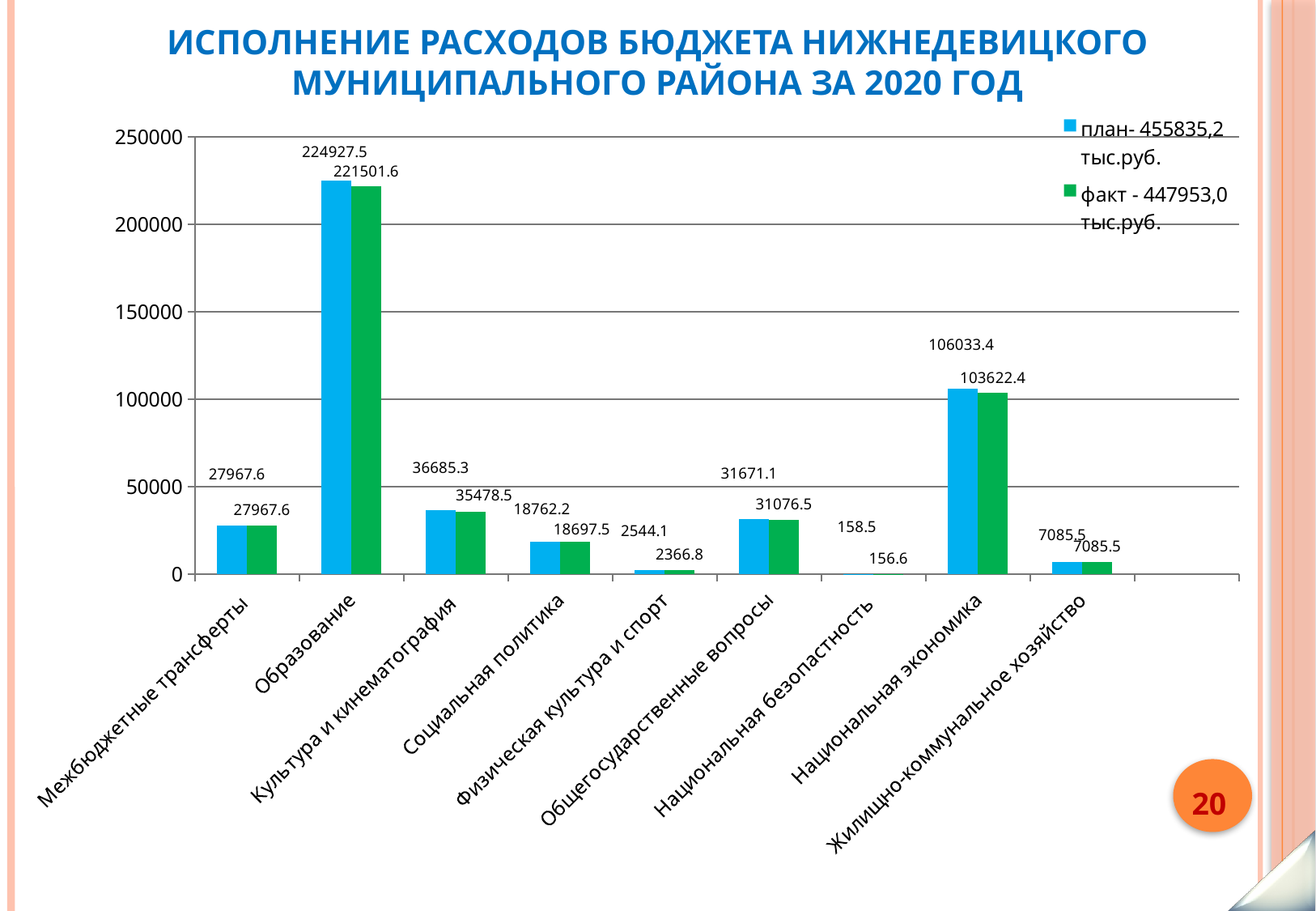
What kind of chart is shown on the slide? Bar chart How many categories are shown on the x axis? 9 Which category has the highest план value? Образование What is the difference between the план and факт values for Образование? 3425.9 What is the план value for Национальная безопасность? 158.5 What is the difference between the план and факт values for Национальная экономика? 2411.0 Which is larger: the план value for Общегосударственные вопросы or the план value for Культура и кинематография? Культура и кинематография What is the факт value for Физическая культура и спорт? 2366.8 Which category has the lowest факт value? Национальная безопасность What is the план value for Образование? 224927.5 What is the факт value for Национальная экономика? 103622.4 How many series does the legend list? 2